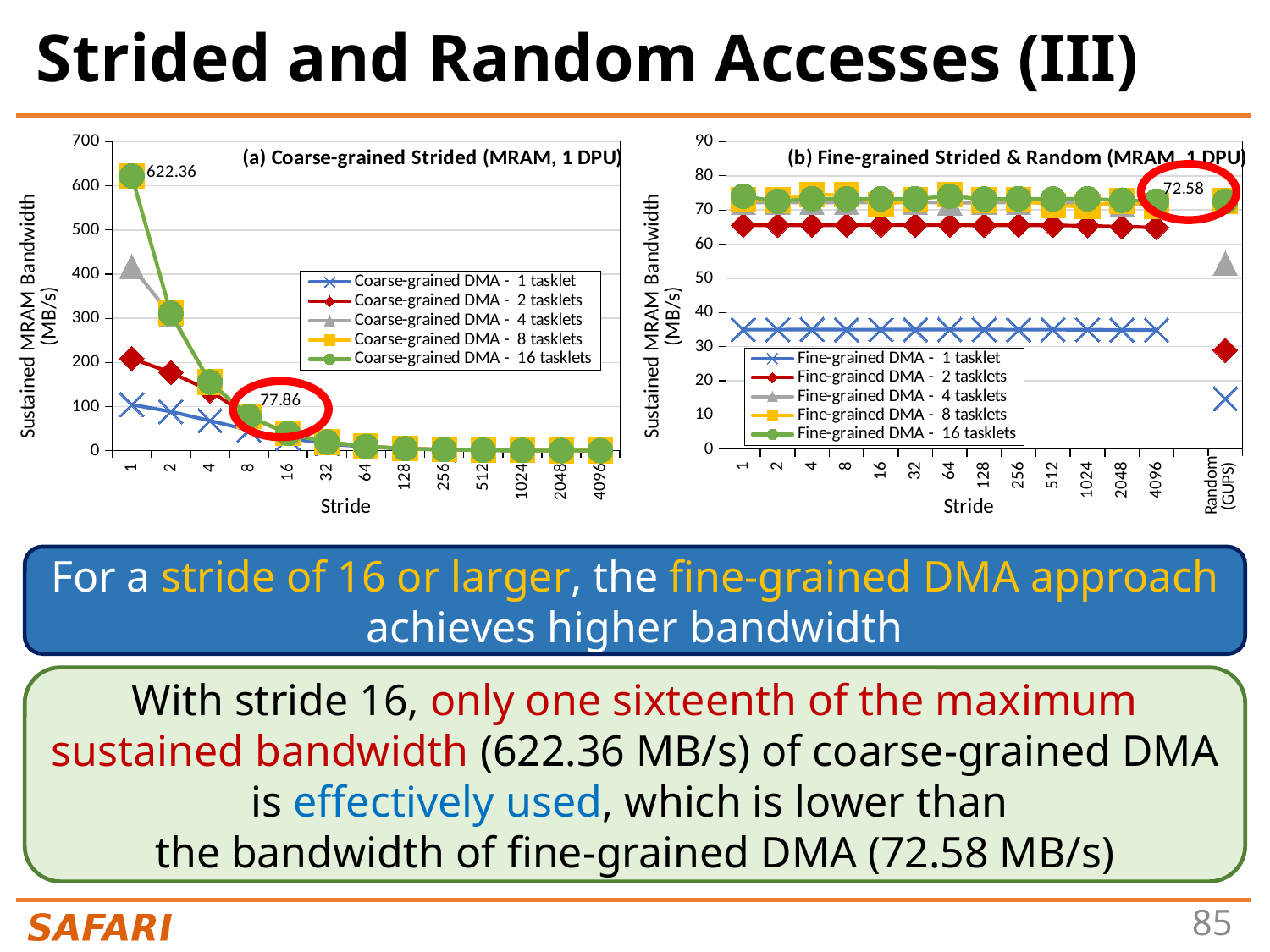
What kind of chart is chart (a) Coarse-grained Strided (MRAM, 1 DPU)? line chart How many stride values are shown on the x axis of chart (a) Coarse-grained Strided? 13 How many categories are shown on the x axis of chart (b) Fine-grained Strided & Random, including Random (GUPS)? 14 In chart (a) Coarse-grained Strided, what value is labeled at stride 1? 622.36 In chart (b) Fine-grained Strided & Random, which series has the lowest value at Random (GUPS)? Fine-grained DMA - 1 tasklet In chart (b) Fine-grained Strided & Random, is the value for Fine-grained DMA - 1 tasklet at stride 1 greater or less than 40? less In chart (a) Coarse-grained Strided, does the Coarse-grained DMA - 16 tasklets series rise or fall as the stride increases? fall How many series does the legend of chart (a) Coarse-grained Strided list? 5 In chart (a) Coarse-grained Strided, is the value for Coarse-grained DMA - 1 tasklet at stride 1 greater or less than 200? less In chart (a) Coarse-grained Strided, what is the difference between the labeled value at stride 1 and the labeled value at stride 16? 544.50 In chart (a) Coarse-grained Strided, what value is labeled at stride 16? 77.86 How many series does the legend of chart (b) Fine-grained Strided & Random list? 5